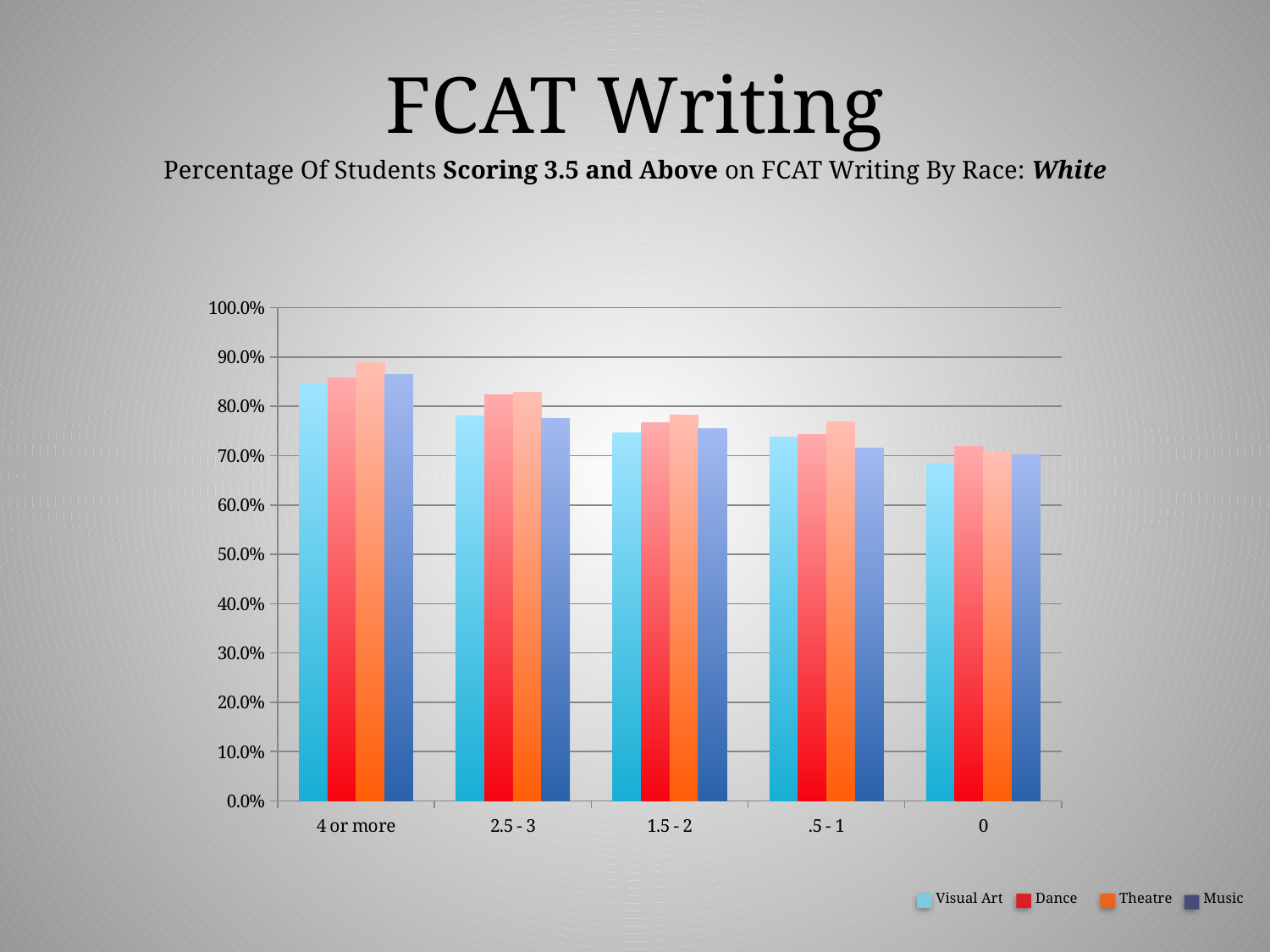
How many categories are shown on the x axis? 5 In which category is the Theatre series highest? 4 or more Is the value for Visual Art in the '4 or more' category greater or less than 80.0%? greater What kind of chart is shown on the slide? bar chart Which series has the highest value in the '4 or more' category? Theatre Is the value for Music in the '.5 - 1' category greater or less than 80.0%? less What colour represents the Theatre series in the legend? orange How many series does the legend list? 4 Do the Visual Art values rise or fall moving from '4 or more' to '0' along the x axis? fall Is the value for Theatre in the '4 or more' category greater or less than 80.0%? greater Which series has the lowest value in the '0' category? Visual Art